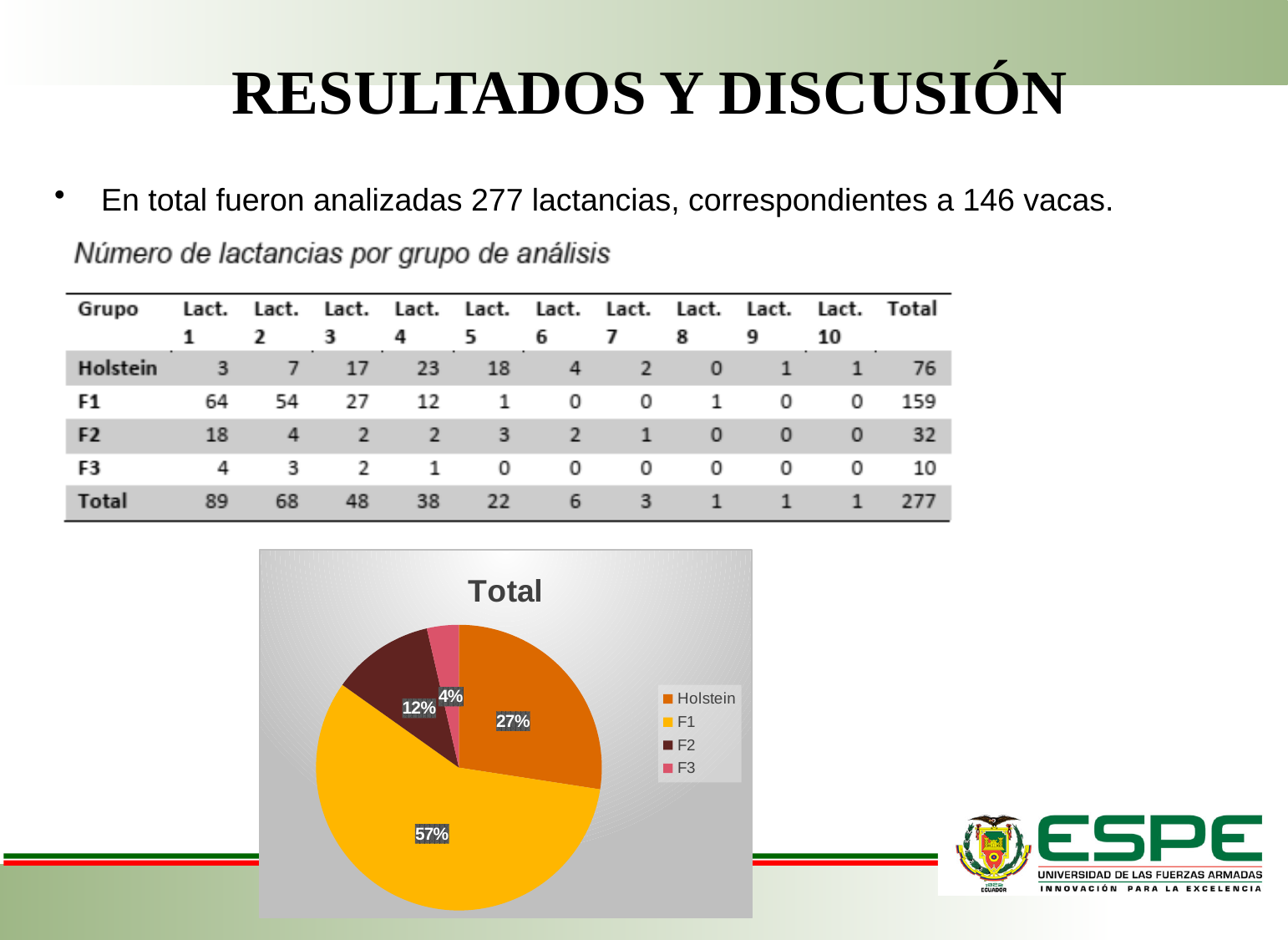
How many groups are shown in the pie chart? 4 What is the difference in percentage points between the F1 slice and the Holstein slice? 30% Which slice is larger, Holstein or F2? Holstein What is the title of the pie chart? Total Which group has the smallest slice of the pie? F3 Which group has the largest slice of the pie? F1 How many entries does the legend of the pie chart list? 4 What share of the pie does F3 represent? 4% What kind of chart is shown on the slide? pie chart What share of the pie does Holstein represent? 27% What share of the pie does F1 represent? 57%